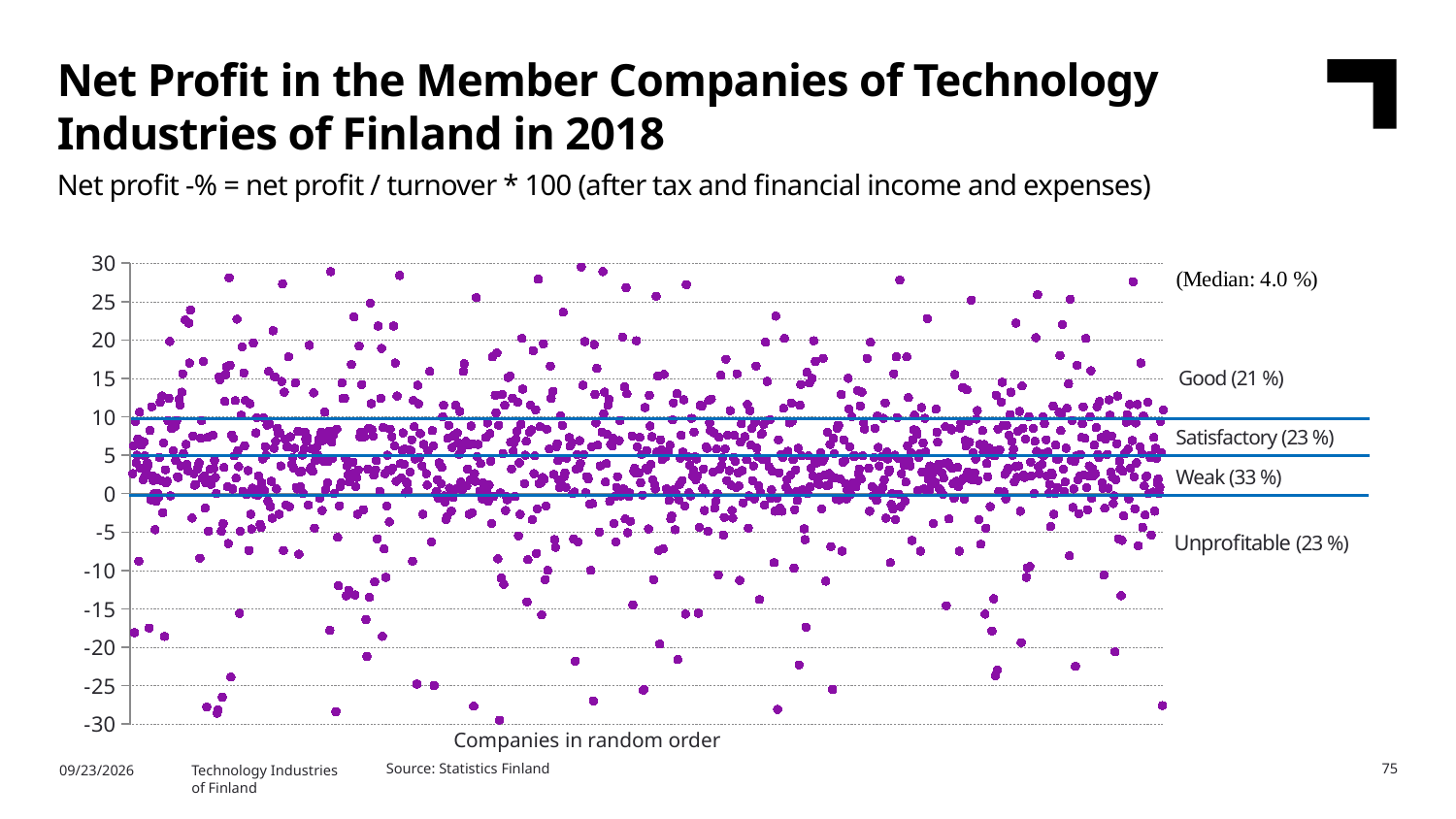
Which profitability category has the largest share of companies? Weak What share of companies falls into the 'Good' category? 21 % What kind of chart is shown on the slide? Scatter chart What is the highest value shown on the y axis? 30 Which category has a larger share of companies, Good or Weak? Weak What is the median net profit percentage shown on the chart? 4.0 % What share of companies falls into the 'Weak' category? 33 % What is the label of the x axis? Companies in random order What share of companies falls into the 'Unprofitable' category? 23 % Which profitability category has the smallest share of companies? Good What is the difference in percentage points between the Weak share and the Good share? 12 How many profitability categories are labelled on the chart? 4